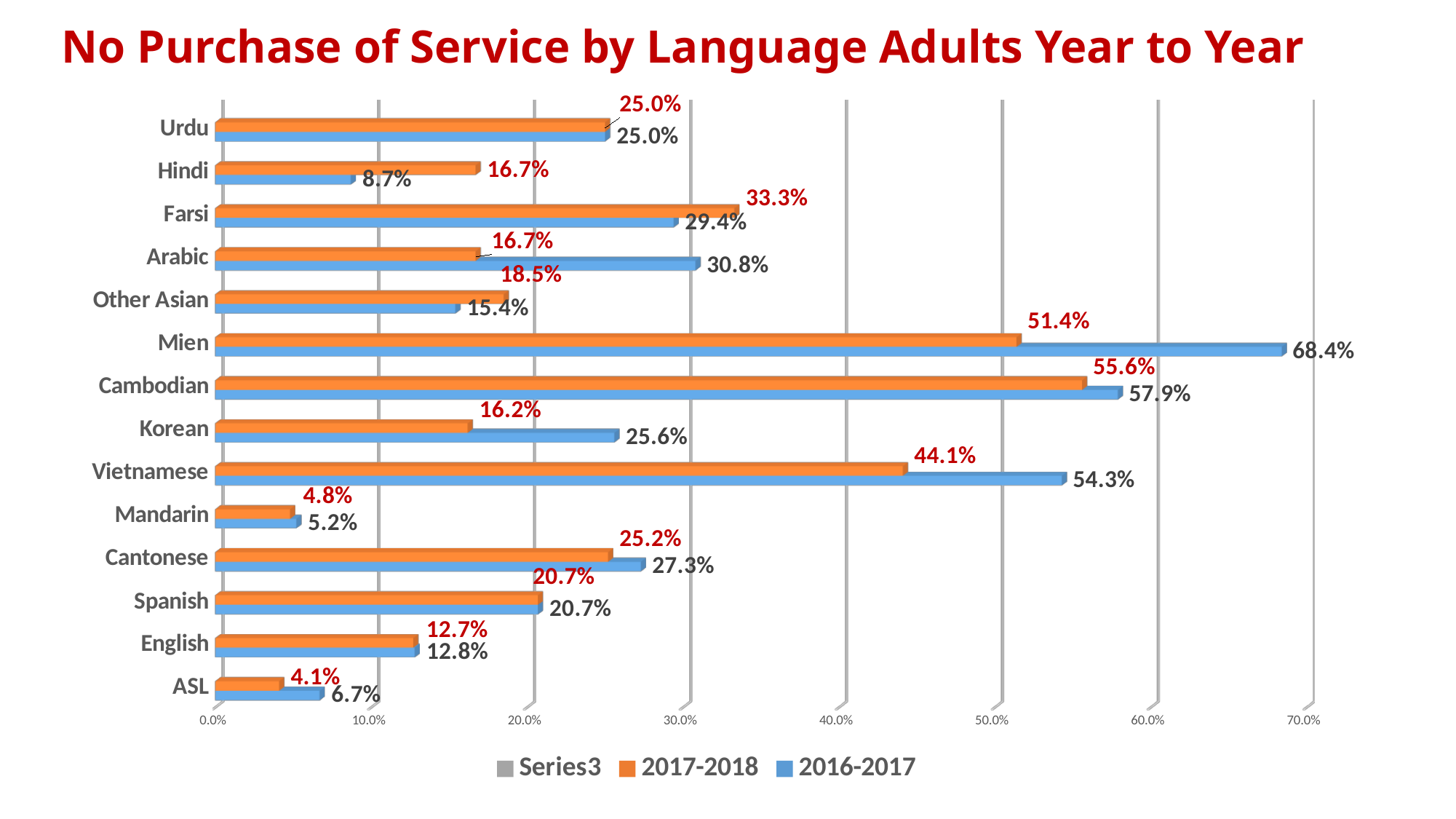
Is the 2016-2017 value for Vietnamese greater or less than 50%? greater What is the 2016-2017 value for Mien? 68.4% What kind of chart is shown on the slide? Bar chart For Arabic, which is larger: the 2016-2017 value or the 2017-2018 value? 2016-2017 Which language has the lowest 2017-2018 value? ASL Which language has the highest 2016-2017 value? Mien What is the 2016-2017 value for Korean? 25.6% What is the 2017-2018 value for Hindi? 16.7% What is the 2017-2018 value for Cambodian? 55.6% What is the difference between the 2016-2017 and 2017-2018 values for Mien? 17.0% How many series does the legend list? 3 How many languages are shown on the chart? 14